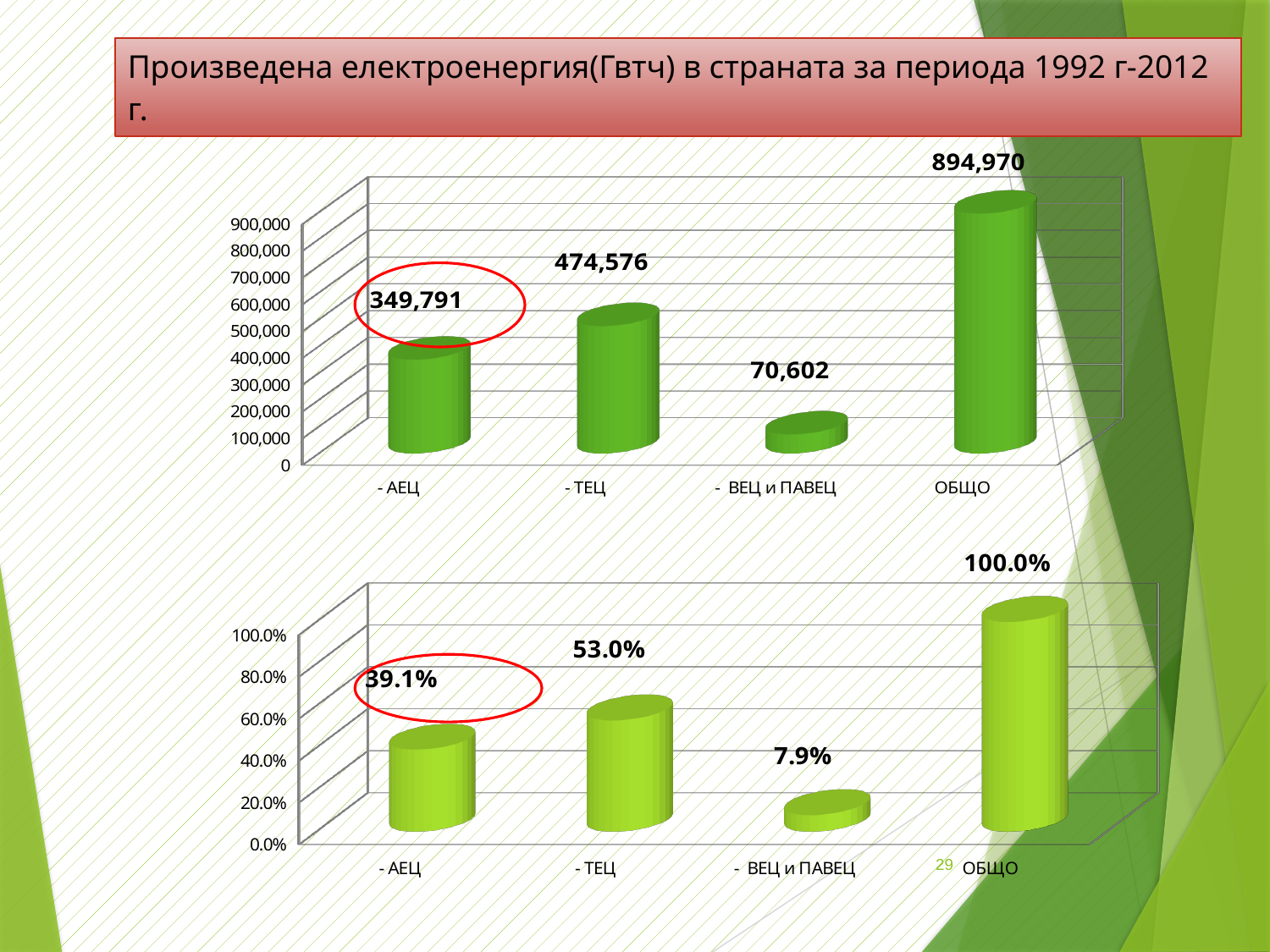
In the bottom chart, what is the value for ВЕЦ и ПАВЕЦ? 7.9% In the top chart, how many categories are shown? 4 In the top chart, which category has the lowest value? ВЕЦ и ПАВЕЦ In the top chart, what is the difference between the values for ТЕЦ and АЕЦ? 124,785 In the top chart, what is the value for ВЕЦ и ПАВЕЦ? 70,602 In the bottom chart, which category has the highest value? ОБЩО What kind of chart is the bottom chart? bar chart In the bottom chart, what is the value for АЕЦ? 39.1% In the top chart, which is larger, the value for АЕЦ or the value for ТЕЦ? ТЕЦ In the top chart, what is the value for ТЕЦ? 474,576 In the bottom chart, what is the difference between the values for ТЕЦ and АЕЦ? 13.9% In the top chart, what is the value for ОБЩО? 894,970